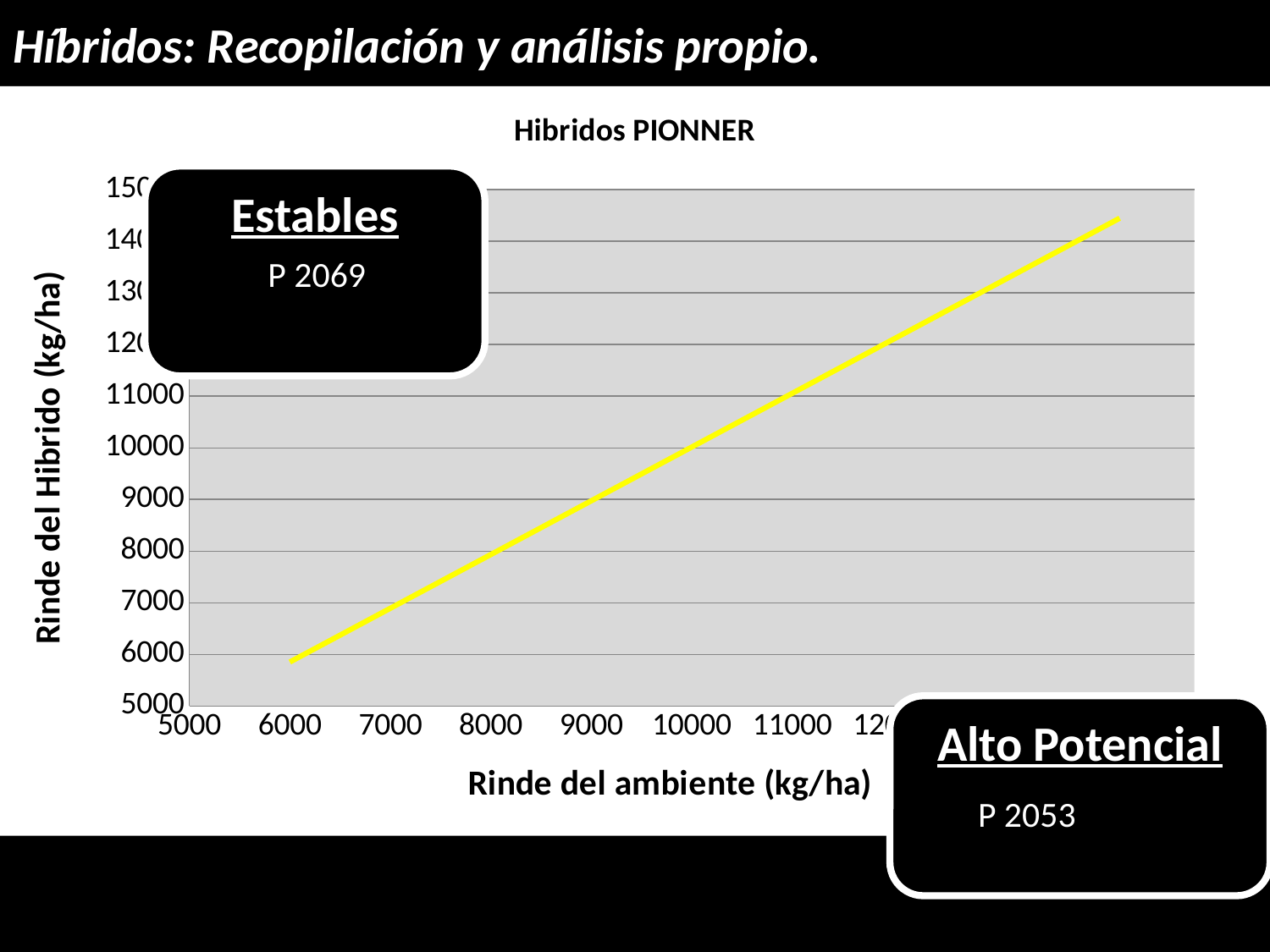
What is the label of the x axis of the chart? Rinde del ambiente (kg/ha) Is the value of the line at a Rinde del ambiente of 7000 greater or less than 8000? less Is the value of the line at its right-hand end greater or less than 14000? greater Is the value of the line at a Rinde del ambiente of 10000 greater or less than 11000? less What is the title of the chart? Hibridos PIONNER Does the plotted line rise or fall as Rinde del ambiente increases? rise How many lines are plotted on the chart? 1 What kind of chart is shown on the slide? line chart